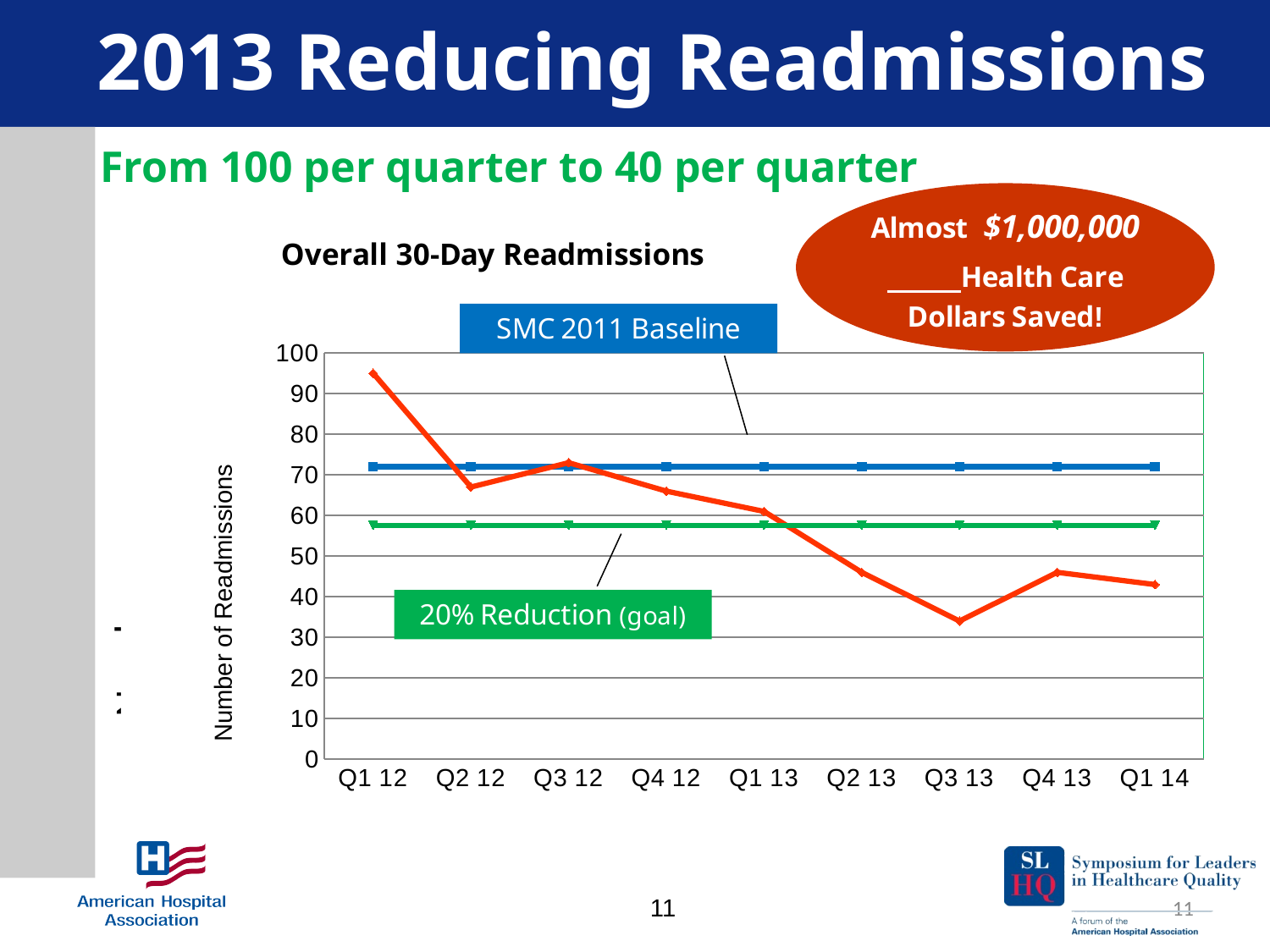
Is the number of readmissions for Q3 13 greater or less than 40? less How many quarters are shown along the x axis of the chart? 9 Overall, do the readmissions on the red line rise or fall from Q1 12 to Q1 14? fall What kind of chart is shown on the slide? line chart What is the label on the vertical axis of the chart? Number of Readmissions In which quarter is the number of readmissions (red line) lowest? Q3 13 In which quarter is the number of readmissions (red line) highest? Q1 12 Is the number of readmissions for Q2 12 greater or less than 60? greater What is the title of the chart? Overall 30-Day Readmissions Which quarter has more readmissions, Q1 12 or Q1 14? Q1 12 Is the number of readmissions for Q1 12 greater or less than 90? greater